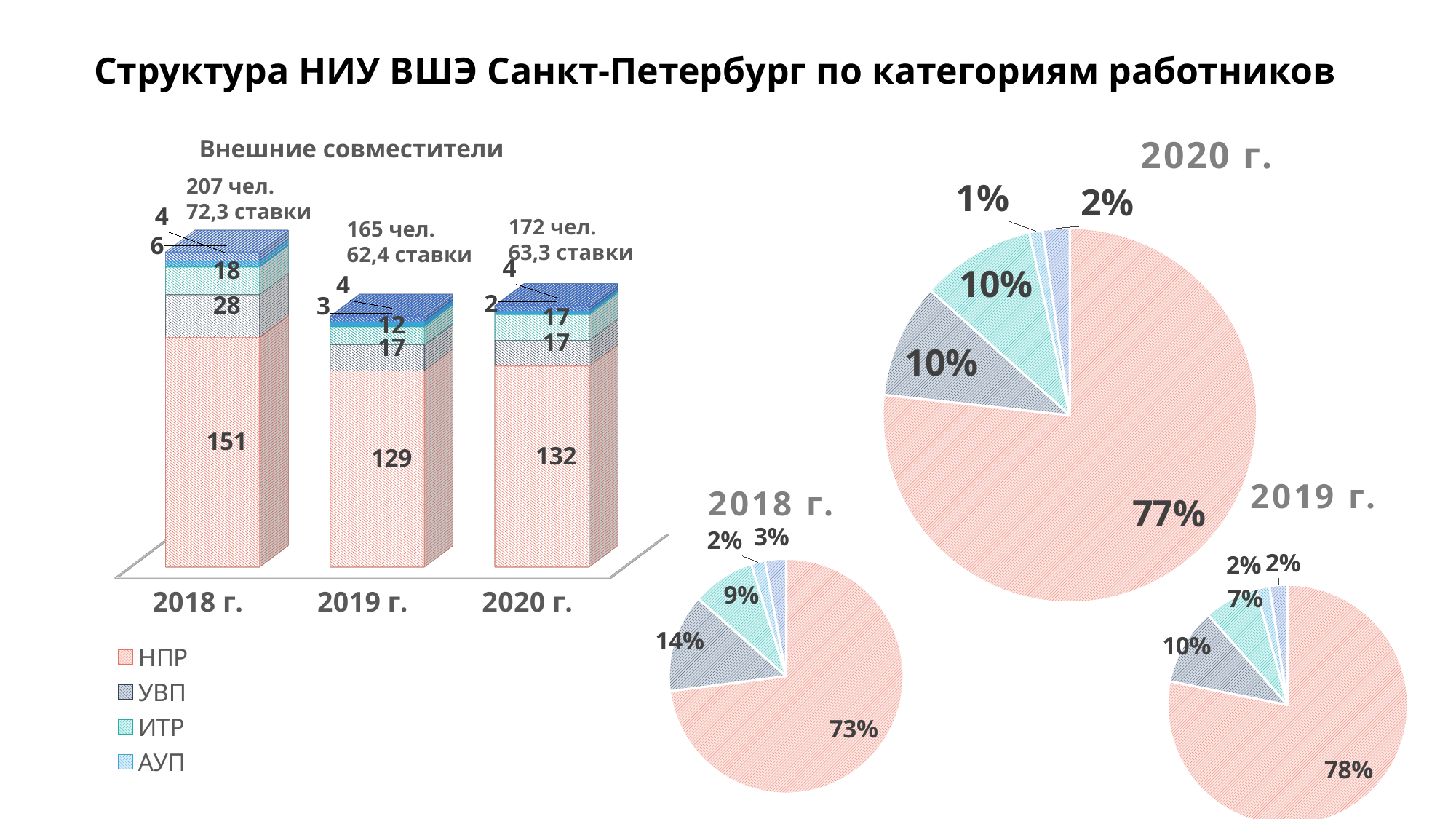
In the bar chart 'Внешние совместители', what is the value of НПР for 2018 г.? 151 In the bar chart 'Внешние совместители', how many years are shown on the x axis? 3 In the bar chart 'Внешние совместители', how many ставки are shown for 2019 г.? 62,4 ставки How many entries does the legend of the bar chart list? 4 In the pie chart for 2019 г., what is the share of the largest slice? 78% In the bar chart 'Внешние совместители', what is the difference between the НПР values for 2018 г. and 2019 г.? 22 In the bar chart 'Внешние совместители', what is the total headcount shown above the 2018 г. bar? 207 чел. In the bar chart 'Внешние совместители', what is the value of НПР for 2020 г.? 132 Which pie chart has the larger share for the largest slice, 2019 г. or 2020 г.? 2019 г. What kind of chart is 'Внешние совместители'? Stacked bar chart In the pie chart for 2018 г., what share does the largest slice (НПР) have? 73% In the bar chart 'Внешние совместители', which year has the highest НПР value? 2018 г.